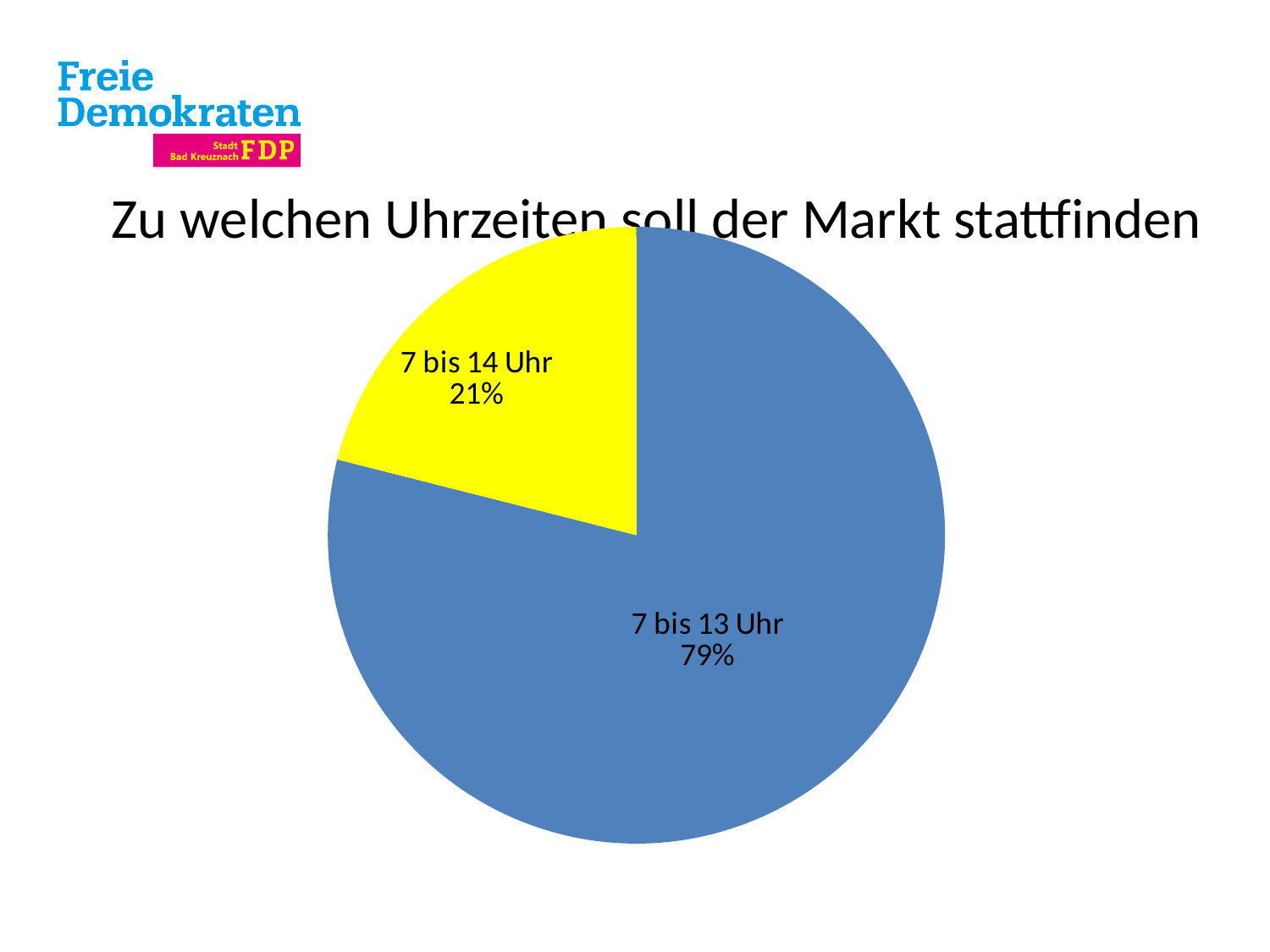
What colour is the "7 bis 14 Uhr" slice? yellow Which slice of the pie is the smallest? 7 bis 14 Uhr Which is larger: the share for "7 bis 13 Uhr" or for "7 bis 14 Uhr"? 7 bis 13 Uhr Is the share for "7 bis 14 Uhr" greater or less than 25%? less What is the title of the chart? Zu welchen Uhrzeiten soll der Markt stattfinden Which slice of the pie is the largest? 7 bis 13 Uhr What share of the pie does "7 bis 14 Uhr" have? 21% What kind of chart is shown on the slide? pie chart What is the difference in percentage points between the "7 bis 13 Uhr" and "7 bis 14 Uhr" slices? 58 How many slices does the pie chart have? 2 What share of the pie does "7 bis 13 Uhr" have? 79%